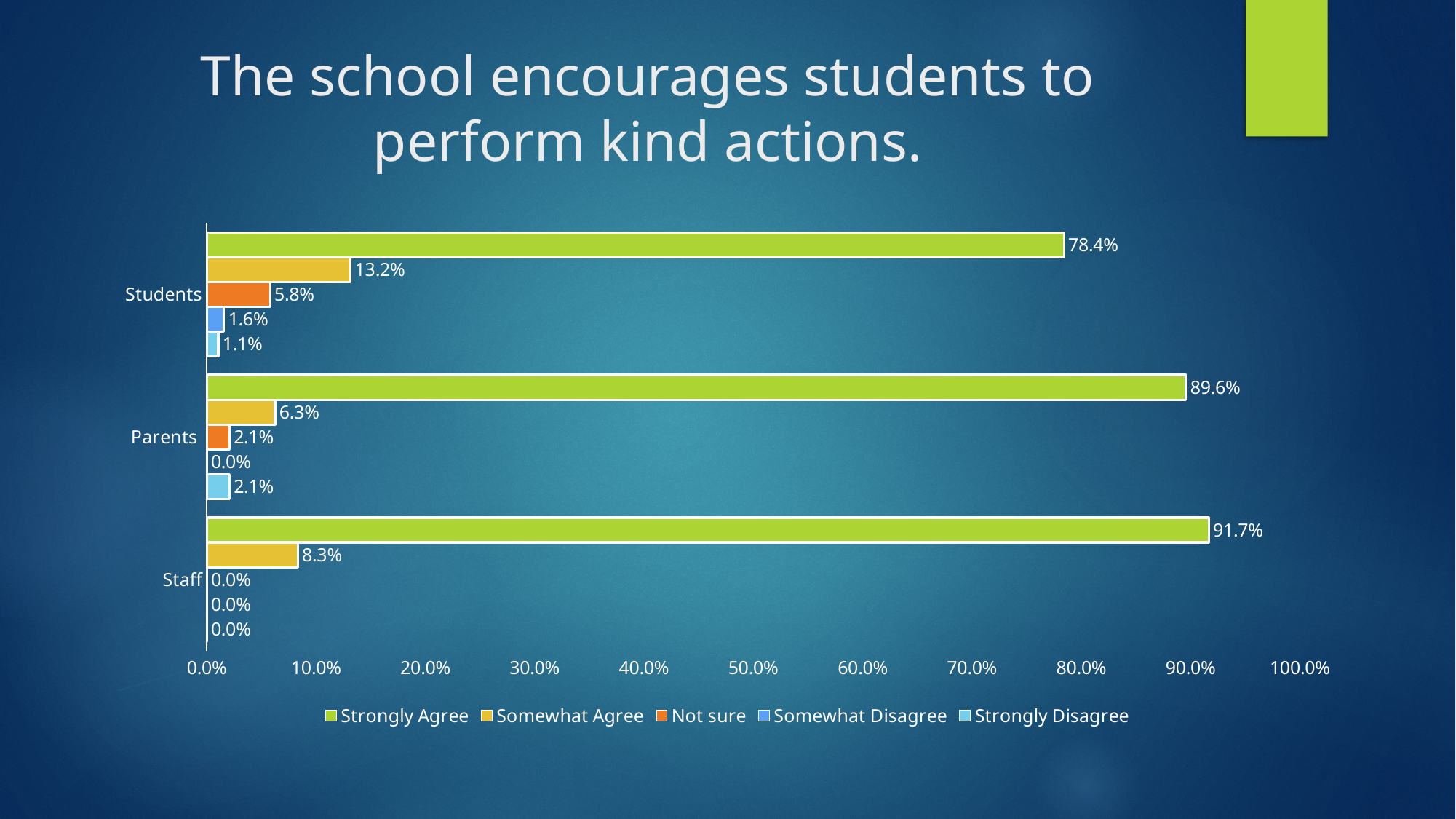
What percentage of Students strongly agree that the school encourages students to perform kind actions? 78.4% What is the Strongly Agree value for Staff? 91.7% Which group has the highest Strongly Agree percentage? Staff How many groups are shown on the vertical axis? 3 Which group has the lowest Strongly Agree percentage? Students What kind of chart is shown on the slide? Bar chart What is the difference between the Strongly Agree values for Staff and Students? 13.3% Which is larger: the Somewhat Agree value for Students or for Staff? Students What is the Somewhat Agree value for Parents? 6.3% What is the Not sure value for Students? 5.8% What is the title of the chart? The school encourages students to perform kind actions. How many series does the legend list? 5